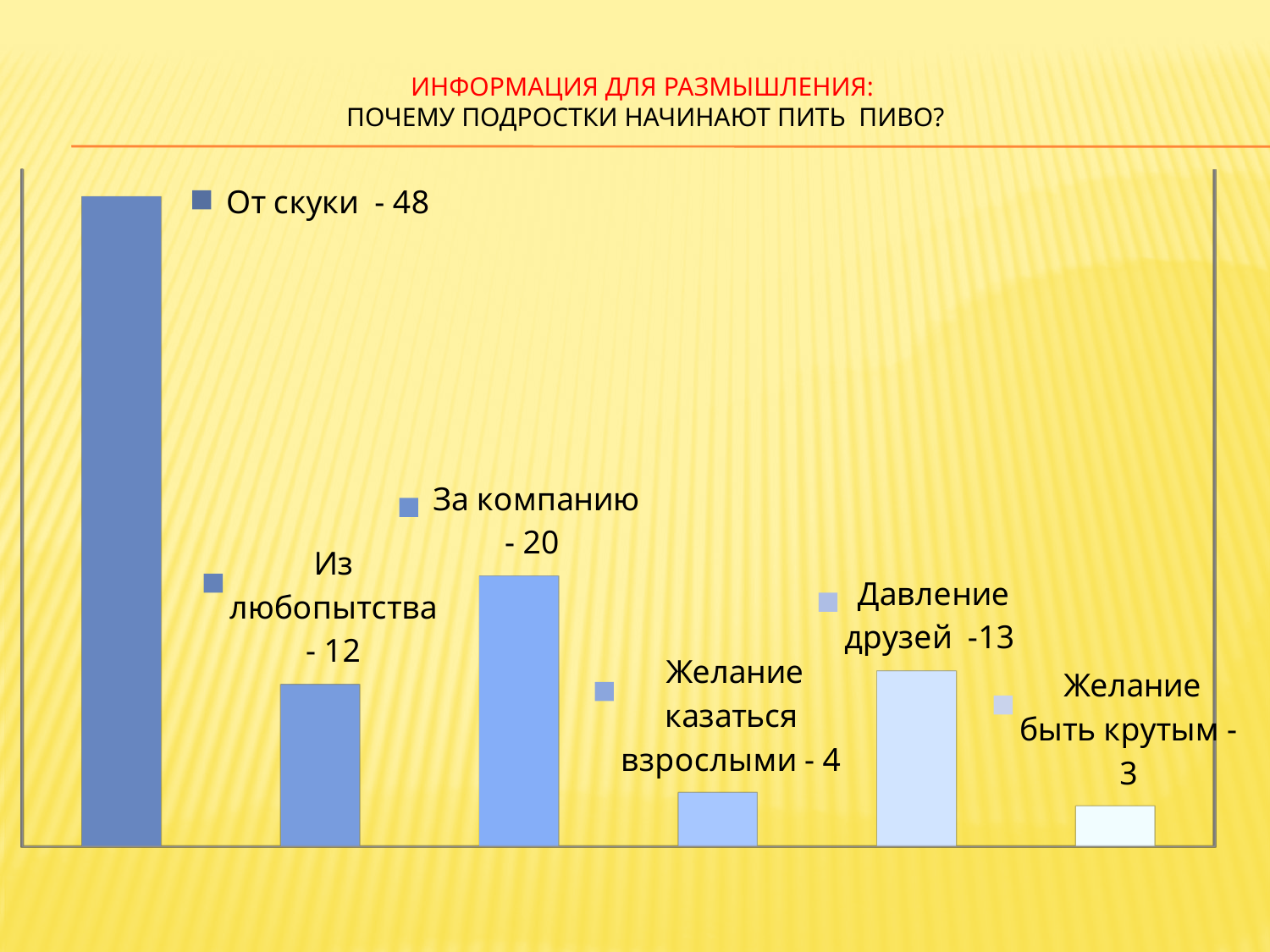
How many bars are shown in the chart? 6 What value is shown for "Желание быть крутым"? 3 Which is larger: the value for "За компанию" or the value for "Из любопытства"? За компанию What value is shown for "Давление друзей"? 13 What is the title of the slide above the chart? Информация для размышления: Почему подростки начинают пить пиво? What is the difference between the values for "Давление друзей" and "Из любопытства"? 1 Which category has the highest value? От скуки What value is shown for "За компанию"? 20 What is the difference between the values for "От скуки" and "За компанию"? 28 What kind of chart is shown on the slide? Bar chart Which category has the lowest value? Желание быть крутым What value is shown for "От скуки"? 48